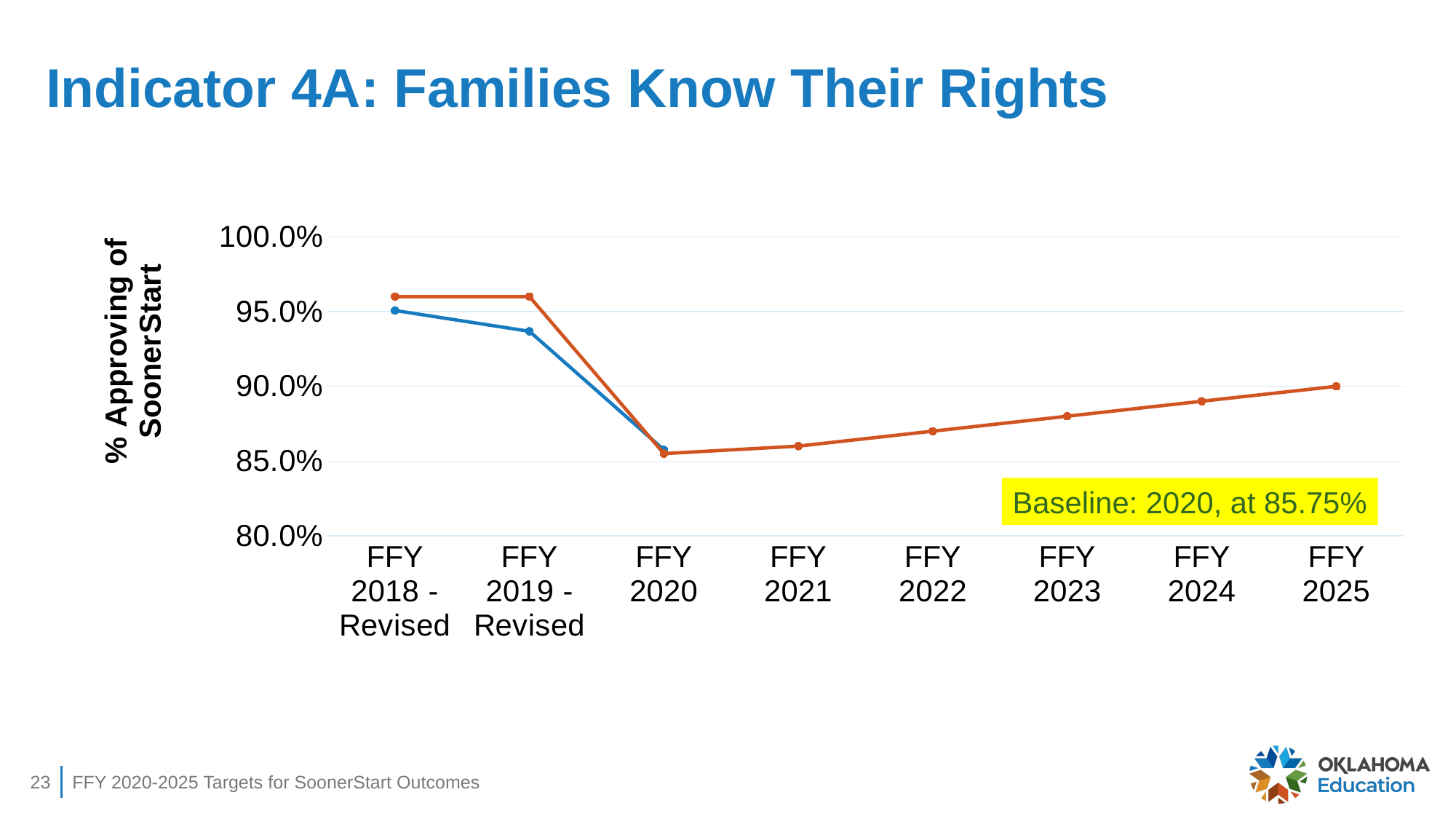
At which category does the orange line reach its lowest value? FFY 2020 What kind of chart is shown on the slide? line chart Is the orange line's value for FFY 2023 greater or less than 90.0%? less At FFY 2019 - Revised, which line is higher, the orange line or the blue line? orange Is the orange line's value for FFY 2018 - Revised greater or less than 95.0%? greater How many categories are shown on the x axis of the chart? 8 What is the orange line's value for FFY 2025? 90.0% What is the title of the y axis? % Approving of SoonerStart Is the blue line's value for FFY 2019 - Revised greater or less than 90.0%? greater What baseline value is stated in the highlighted annotation on the chart? 85.75% Does the orange line rise or fall from FFY 2020 to FFY 2025? rise